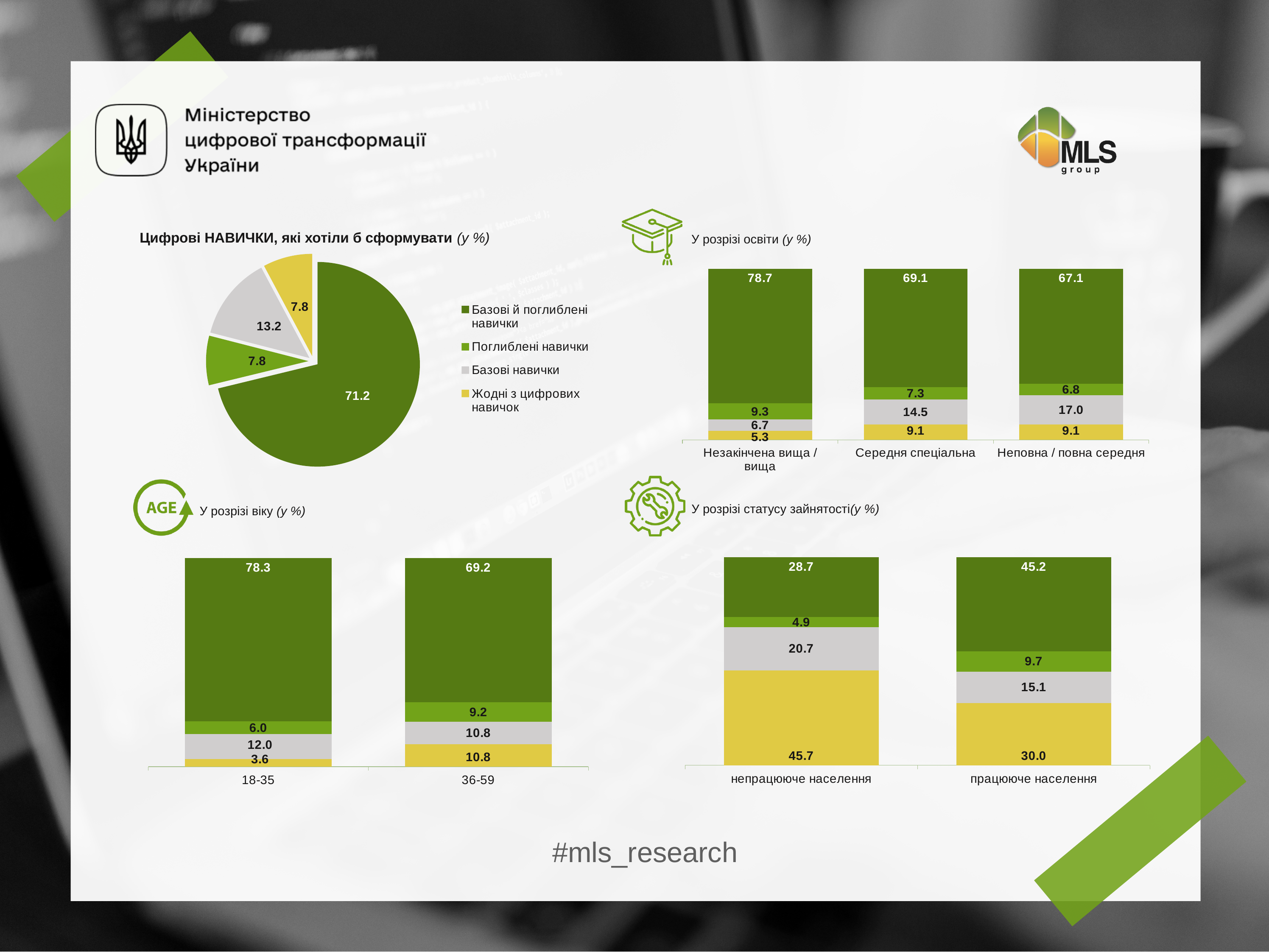
In the pie chart 'Цифрові НАВИЧКИ, які хотіли б сформувати', what is the value for 'Базові й поглиблені навички'? 71.2 What type of chart is 'У розрізі статусу зайнятості'? Stacked bar chart In the chart 'У розрізі статусу зайнятості', which group has the larger dark green value (Базові й поглиблені навички): 'непрацююче населення' or 'працююче населення'? працююче населення In the pie chart 'Цифрові НАВИЧКИ, які хотіли б сформувати', which category has the largest slice? Базові й поглиблені навички In the chart 'У розрізі освіти', how many education categories are shown on the x axis? 3 In the chart 'У розрізі віку', what is the value of the yellow segment (Жодні з цифрових навичок) for '18-35'? 3.6 In the chart 'У розрізі освіти', what is the value of the grey segment (Базові навички) for 'Неповна / повна середня'? 17.0 How many entries does the legend of the pie chart 'Цифрові НАВИЧКИ, які хотіли б сформувати' list? 4 In the chart 'У розрізі віку', what is the difference between the dark green values for '18-35' and '36-59'? 9.1 In the chart 'У розрізі освіти', which education group has the highest value for the dark green segment (Базові й поглиблені навички)? Незакінчена вища / вища In the chart 'У розрізі освіти', what is the value of the dark green segment (Базові й поглиблені навички) for 'Середня спеціальна'? 69.1 In the chart 'У розрізі статусу зайнятості', what is the value of the yellow segment (Жодні з цифрових навичок) for 'непрацююче населення'? 45.7